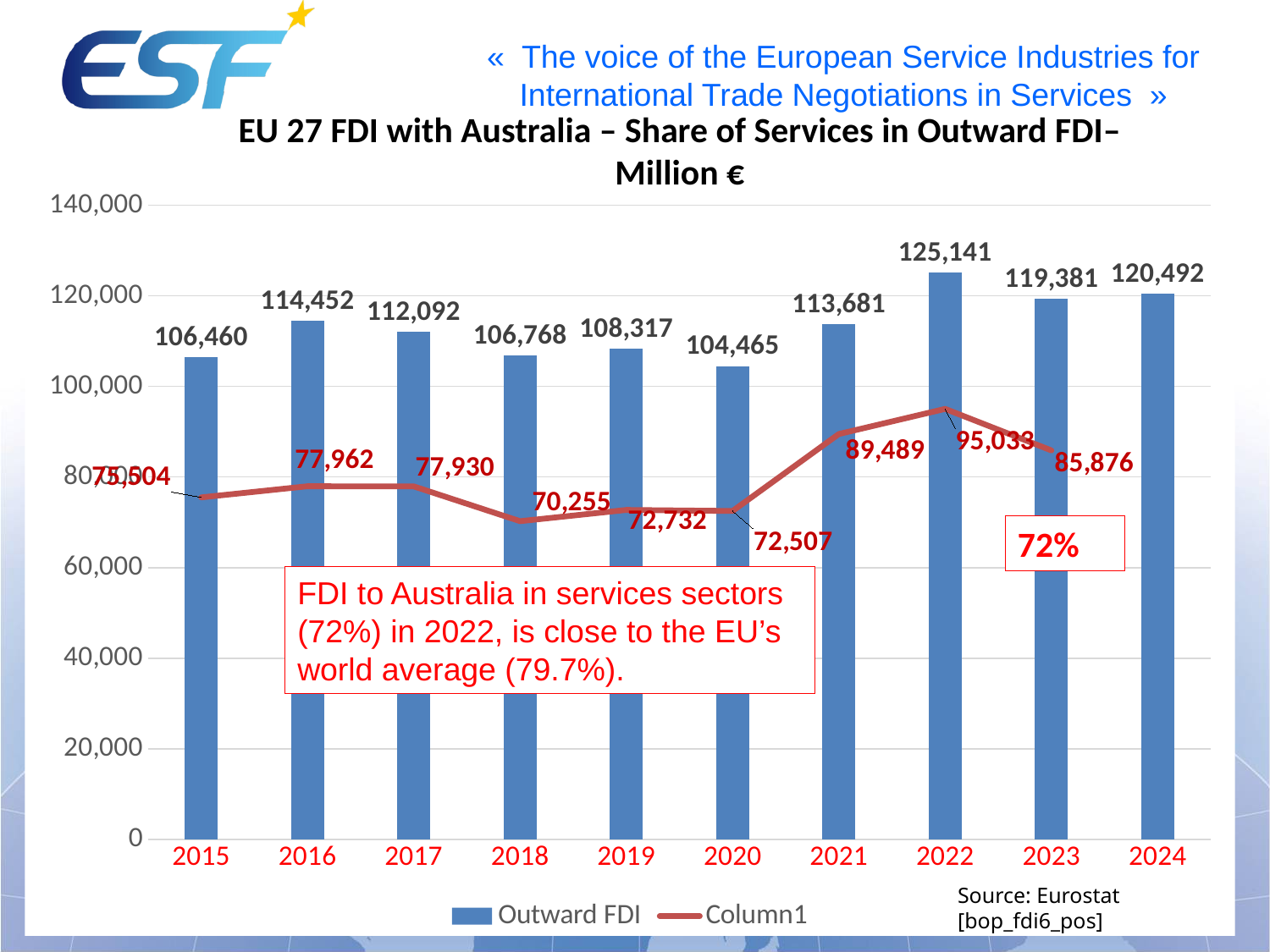
Is the Outward FDI value for 2022 greater or less than 120,000? greater Which year has the lowest value on the Column1 line? 2018 What is the difference between the Outward FDI values for 2022 and 2023? 5,760 What is the Column1 (line) value for 2021? 89,489 Which year has the highest Outward FDI bar? 2022 What is the Outward FDI value for 2020? 104,465 What percentage is shown in the red box near the 2023 data? 72% Which year has a larger Outward FDI value, 2016 or 2017? 2016 What is the Outward FDI value for 2022? 125,141 How many years are shown on the x axis? 10 How many series does the legend list? 2 Which year has the lowest Outward FDI bar? 2020